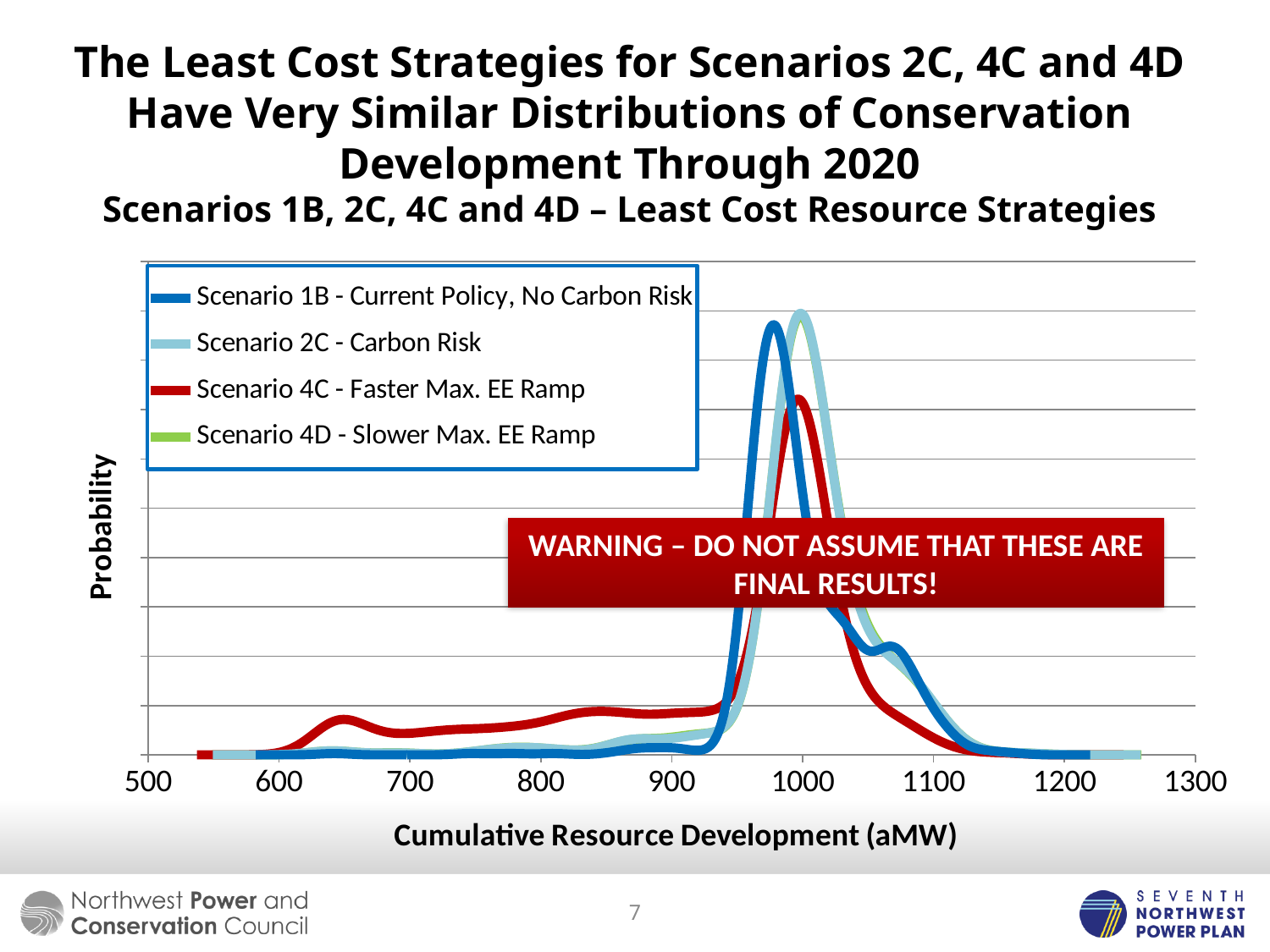
Is the peak of Scenario 1B located at a cumulative resource development greater or less than 1000 aMW? less What is the title of the y axis? Probability How many tick labels are shown on the x axis? 9 What kind of chart is shown on the slide? Line chart How many series does the legend list? 4 Which series begins furthest to the left along the x axis? Scenario 4C - Faster Max. EE Ramp Which series has the highest peak? Scenario 2C - Carbon Risk Which has the higher peak, Scenario 1B or Scenario 4C? Scenario 1B What is the lowest value shown on the x axis? 500 Which has the higher peak, Scenario 2C or Scenario 4C? Scenario 2C What is the title of the x axis? Cumulative Resource Development (aMW)